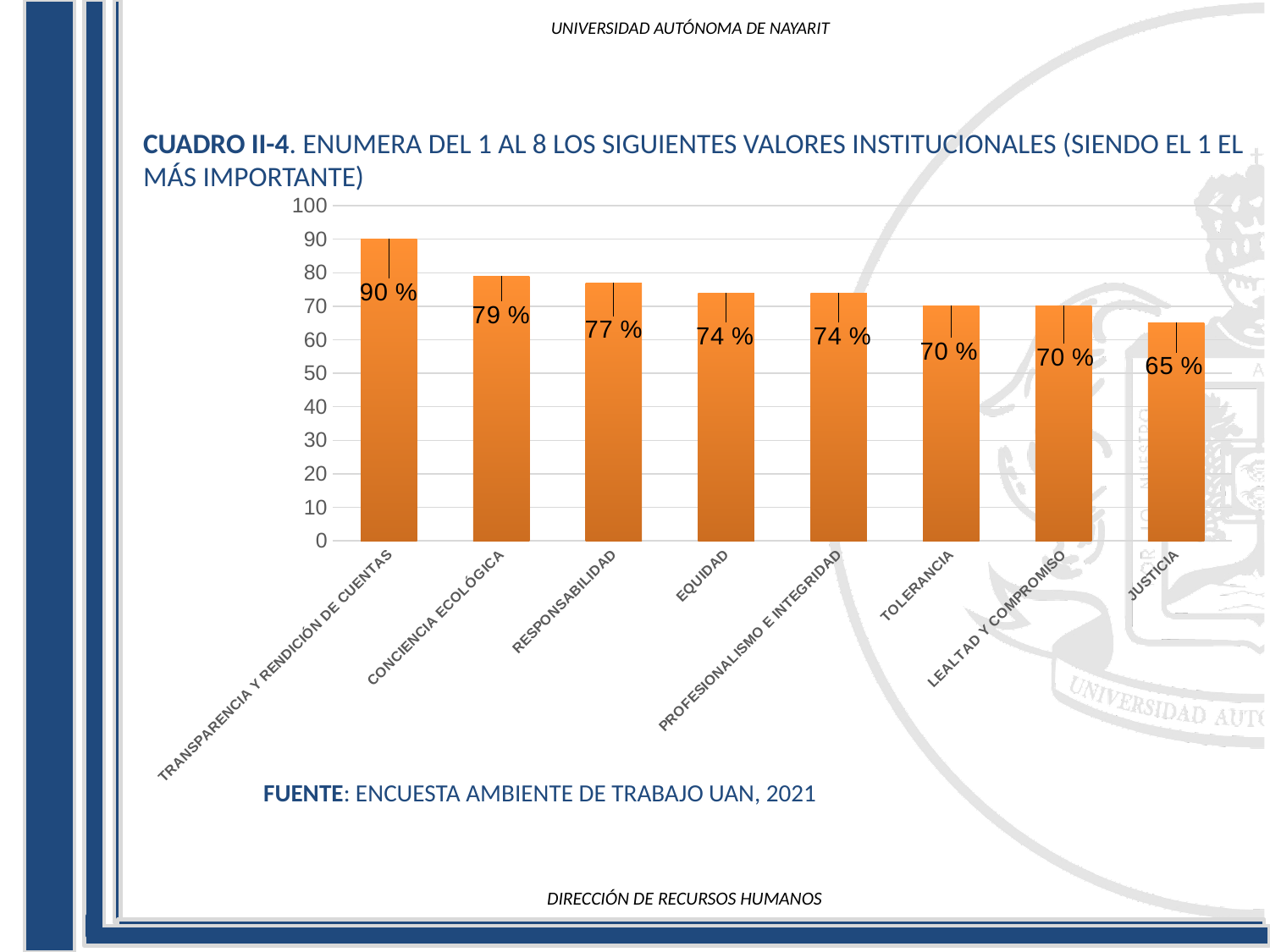
What is the value for TOLERANCIA? 70 % Which category has the highest value? TRANSPARENCIA Y RENDICIÓN DE CUENTAS Which category has the lowest value? JUSTICIA What is the value for TRANSPARENCIA Y RENDICIÓN DE CUENTAS? 90 % What is the value for CONCIENCIA ECOLÓGICA? 79 % Do the values rise or fall from left to right along the x axis? Fall Which is larger, the value for CONCIENCIA ECOLÓGICA or the value for LEALTAD Y COMPROMISO? CONCIENCIA ECOLÓGICA What is the value for JUSTICIA? 65 % What kind of chart is shown on the slide? Bar chart What is the difference between the values for TRANSPARENCIA Y RENDICIÓN DE CUENTAS and JUSTICIA? 25 % How many categories are shown on the x axis? 8 What is the difference between the values for RESPONSABILIDAD and EQUIDAD? 3 %